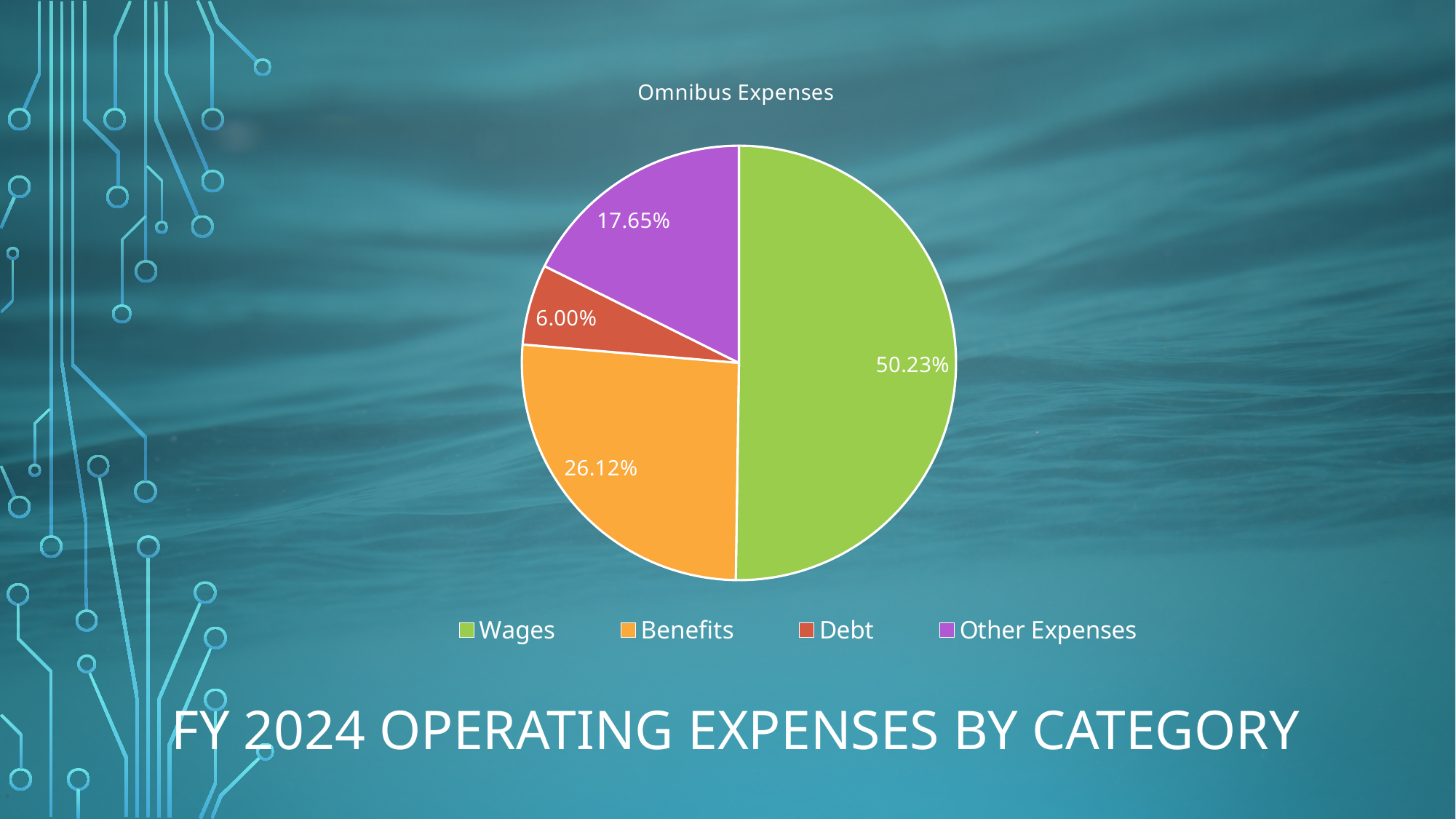
What share of the pie does Other Expenses take? 17.65% What share of the pie does Debt take? 6.00% What share of the pie does Benefits take? 26.12% Which is larger, the Benefits slice or the Other Expenses slice? Benefits What is the difference in percentage points between the Wages slice and the Benefits slice? 24.11 Which category has the largest slice of the pie? Wages What kind of chart is shown on the slide? pie chart What is the title of the chart? Omnibus Expenses Which category has the smallest slice of the pie? Debt What colour is the Debt slice? red How many categories does the pie chart have? 4